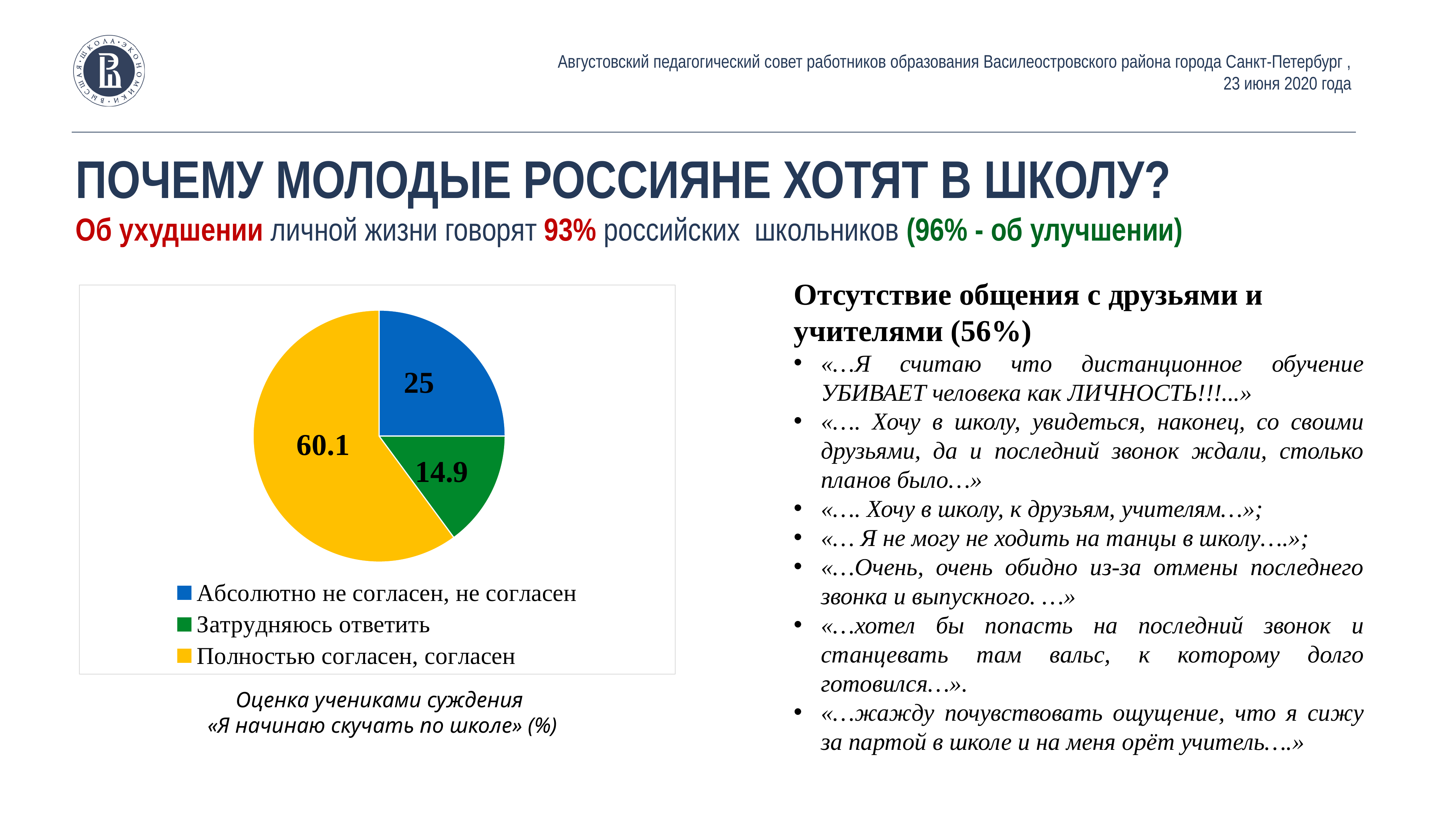
Which category has the largest slice of the pie? Полностью согласен, согласен What value is shown for the slice "Полностью согласен, согласен"? 60.1 What is the difference between the values for "Абсолютно не согласен, не согласен" and "Затрудняюсь ответить"? 10.1 How many slices does the pie chart have? 3 What is the difference between the values for "Полностью согласен, согласен" and "Абсолютно не согласен, не согласен"? 35.1 What value is shown for the slice "Затрудняюсь ответить"? 14.9 Which is larger: the slice for "Абсолютно не согласен, не согласен" or the slice for "Затрудняюсь ответить"? Абсолютно не согласен, не согласен What colour is the slice for "Затрудняюсь ответить"? Green What value is shown for the slice "Абсолютно не согласен, не согласен"? 25 What kind of chart is shown on the slide? Pie chart What statement is the pie chart evaluating, according to the caption below it? «Я начинаю скучать по школе» Which category has the smallest slice of the pie? Затрудняюсь ответить